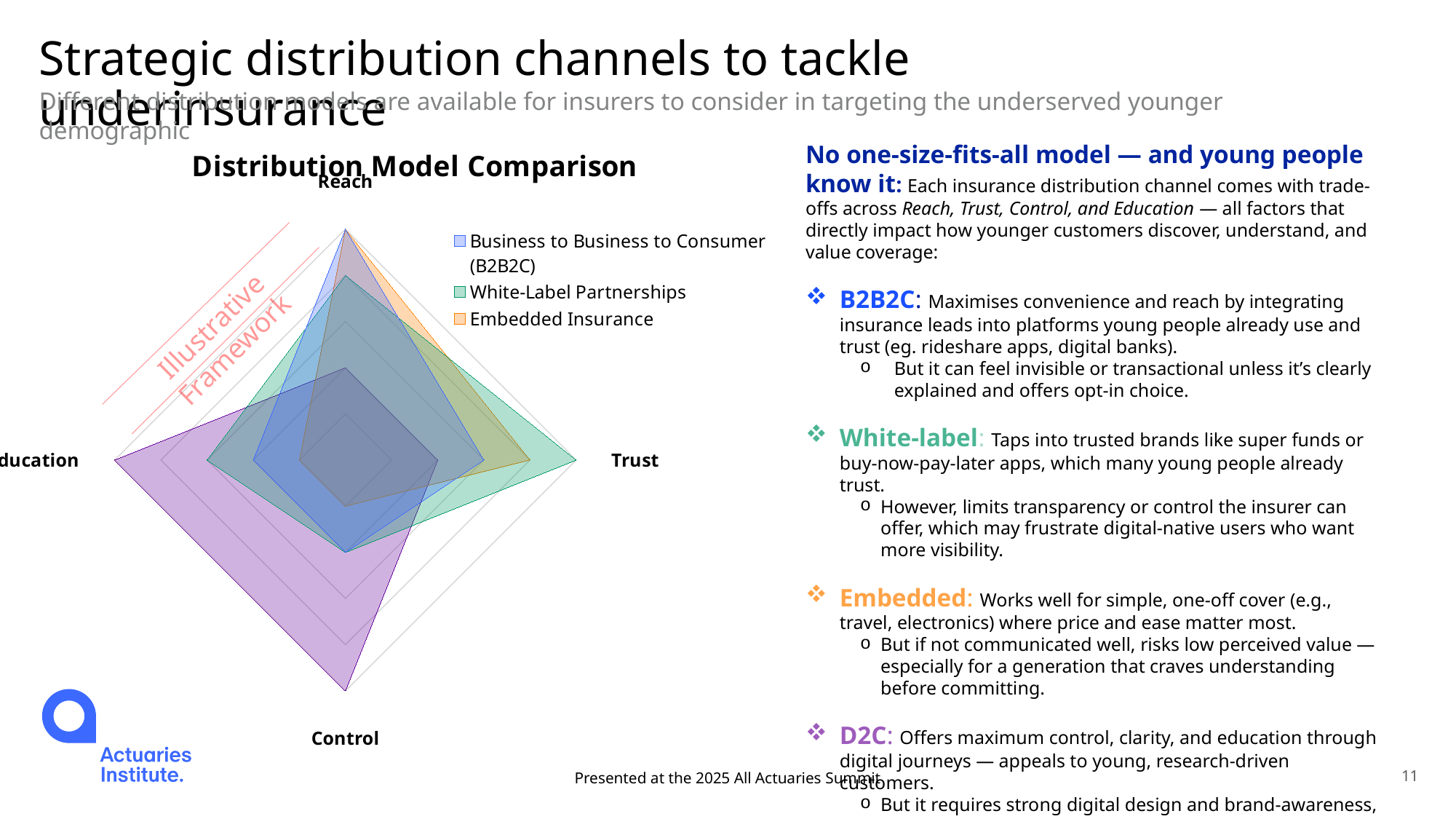
Which series in the legend scores lowest on the Reach axis? White-Label Partnerships How many series does the chart's legend list? 3 What kind of chart is the Distribution Model Comparison chart? Radar chart Which series in the legend scores highest on the Trust axis? White-Label Partnerships On the Control axis, which is larger: Business to Business to Consumer (B2B2C) or Embedded Insurance? Business to Business to Consumer (B2B2C) On the Reach axis, which is larger: Embedded Insurance or White-Label Partnerships? Embedded Insurance Which series in the legend scores lowest on the Education axis? Embedded Insurance How many axes (categories) does the radar chart have? 4 What is the title of the chart on the slide? Distribution Model Comparison Which colour represents Embedded Insurance in the chart legend? Orange On the Trust axis, which is larger: White-Label Partnerships or Business to Business to Consumer (B2B2C)? White-Label Partnerships